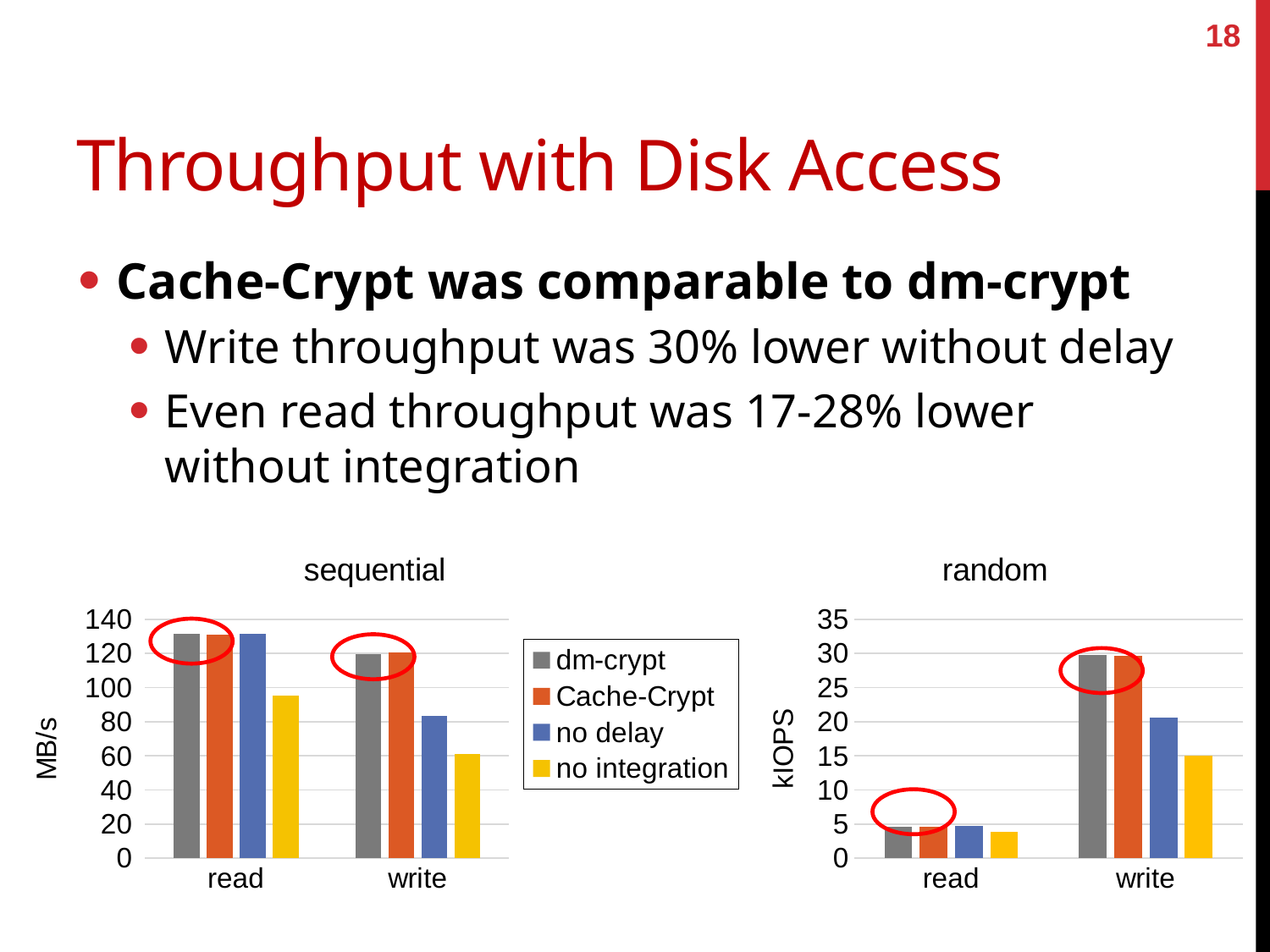
What is the y-axis label of the "random" chart? kIOPS In the "sequential" chart, is the value for no integration at read greater or less than 100? less In the "sequential" chart, which is larger for read: no delay or no integration? no delay In the "random" chart, which series has the lowest value for write? no integration In the "sequential" chart, which series has the lowest value for write? no integration How many categories are on the x axis of the "random" chart? 2 How many series does the legend list? 4 In the "random" chart, do the values for Cache-Crypt rise or fall from read to write? rise What kind of chart is the "sequential" chart? bar chart In the "random" chart, is the value for no integration at write greater or less than 20? less In the "random" chart, is the value for dm-crypt at write greater or less than 25? greater